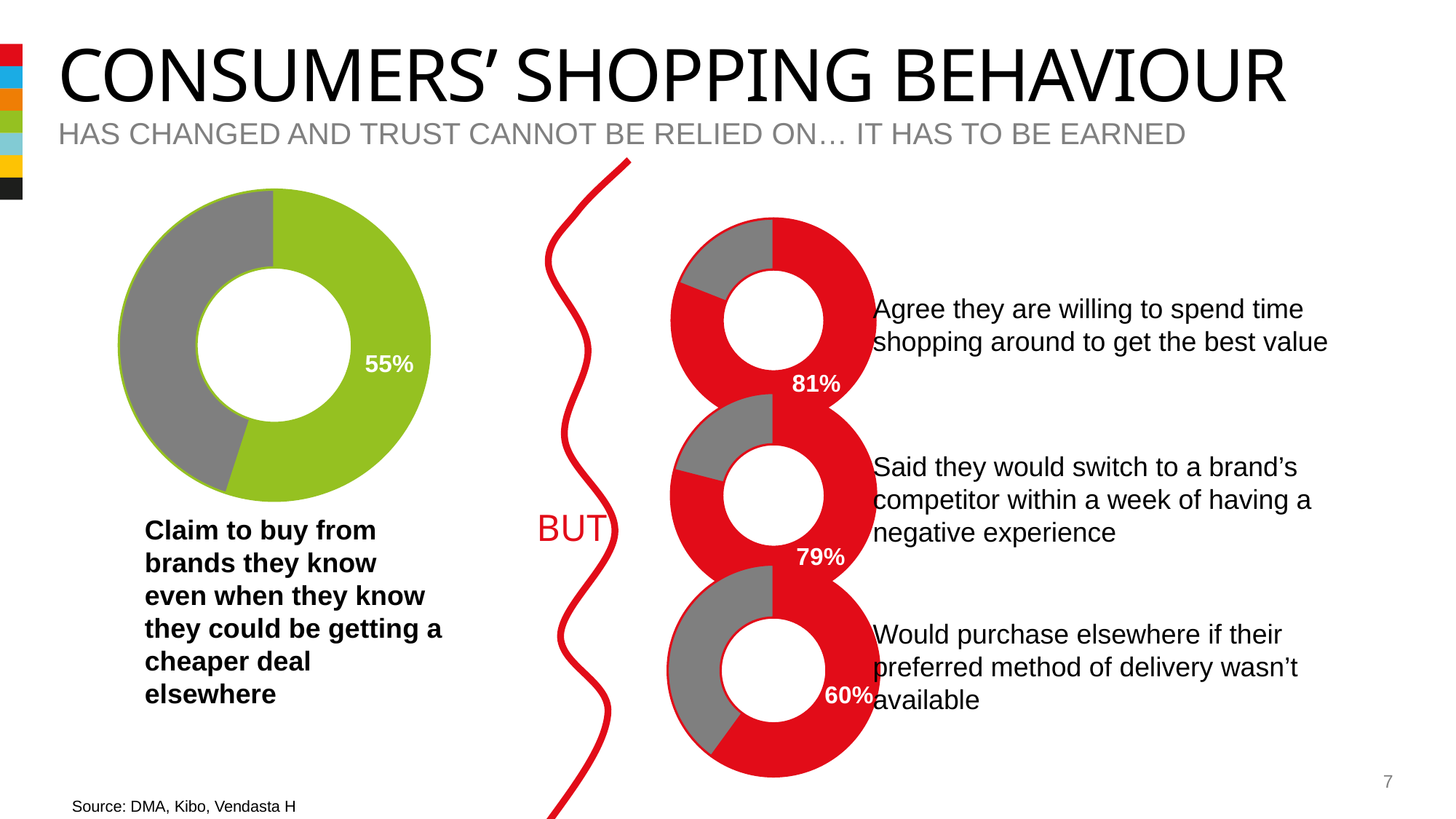
What colour is the highlighted segment in the donut chart on the left of the slide? Green Among the three red donut charts on the right, which statement has the highest percentage? Agree they are willing to spend time shopping around to get the best value What is the difference between the percentage in the top red donut chart (81%) and the bottom red donut chart (60%)? 21% Which is larger: the percentage in the green donut chart on the left or the percentage in the bottom red donut chart on the right? The bottom red donut chart (60%) In the top red donut chart on the right, what percentage agree they are willing to spend time shopping around to get the best value? 81% What type of chart is used to show the 55% value on the left of the slide? Donut (pie) chart In the green donut chart on the left, what percentage claim to buy from brands they know even when they could get a cheaper deal elsewhere? 55% How many donut charts are shown on the slide? 4 In the bottom red donut chart on the right, what percentage would purchase elsewhere if their preferred method of delivery wasn't available? 60% In the middle red donut chart on the right, what percentage said they would switch to a brand's competitor within a week of having a negative experience? 79% What is the difference between the percentage in the top red donut chart and the middle red donut chart? 2% Among the three red donut charts on the right, which statement has the lowest percentage? Would purchase elsewhere if their preferred method of delivery wasn't available